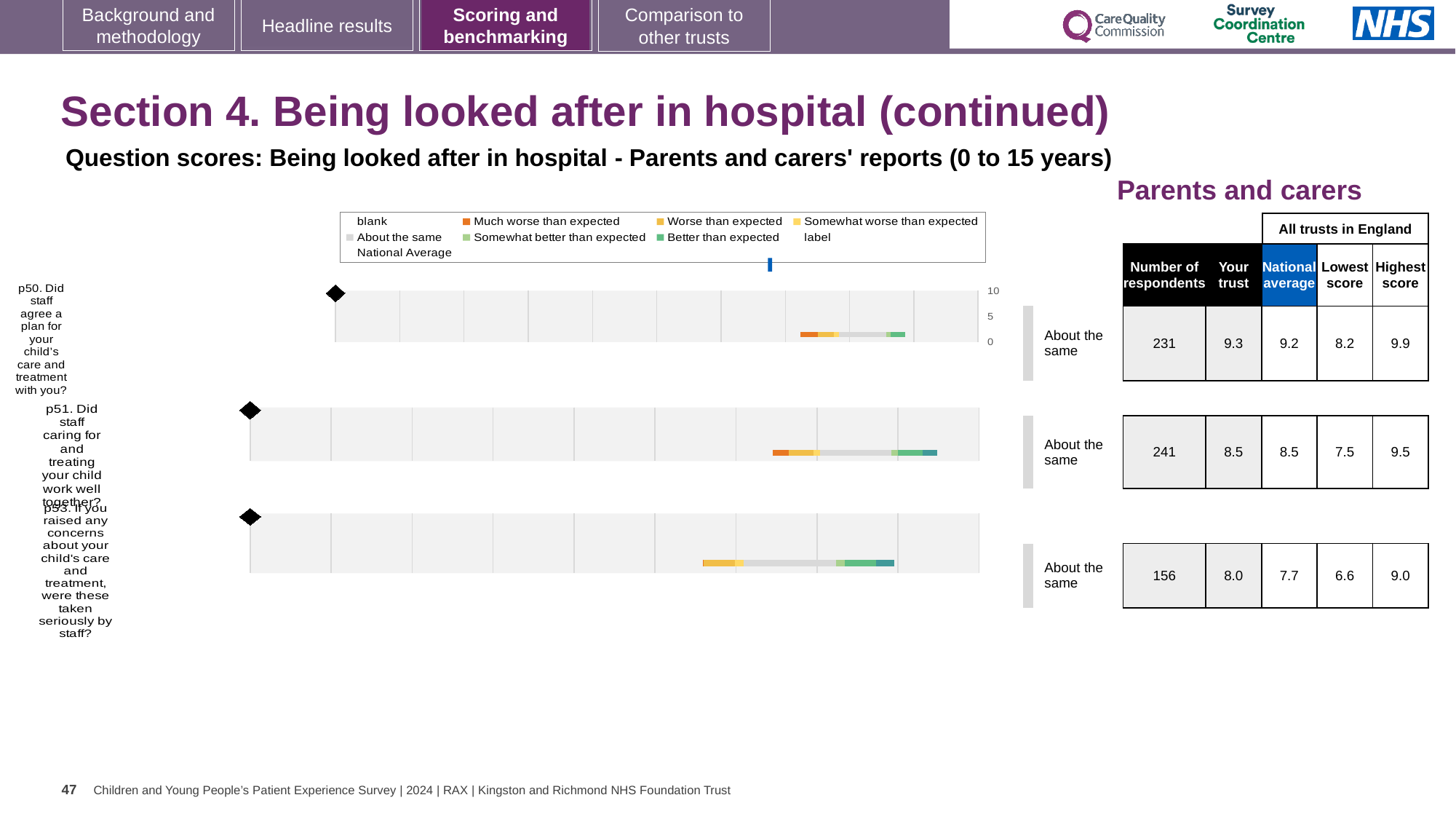
What kind of chart is used to show the question scores on this slide? bar chart What is the National average score for p51 (Did staff caring for and treating your child work well together?)? 8.5 What is the Lowest score across all trusts in England for p53? 6.6 How many respondents are listed for p53 (If you raised any concerns about your child's care and treatment, were these taken seriously by staff?)? 156 For p53, what is the difference between the 'Your trust' score and the National average? 0.3 How many questions (p50, p51, p53) are plotted on the slide? 3 What benchmark category is shown for p51? About the same Which question has the lowest number of respondents? p53 What is the Highest score across all trusts in England for p50? 9.9 For p50, which is larger: the 'Your trust' score or the National average? Your trust What is the 'Your trust' score for p50 (Did staff agree a plan for your child's care and treatment with you?)? 9.3 Which question has the highest 'Your trust' score? p50